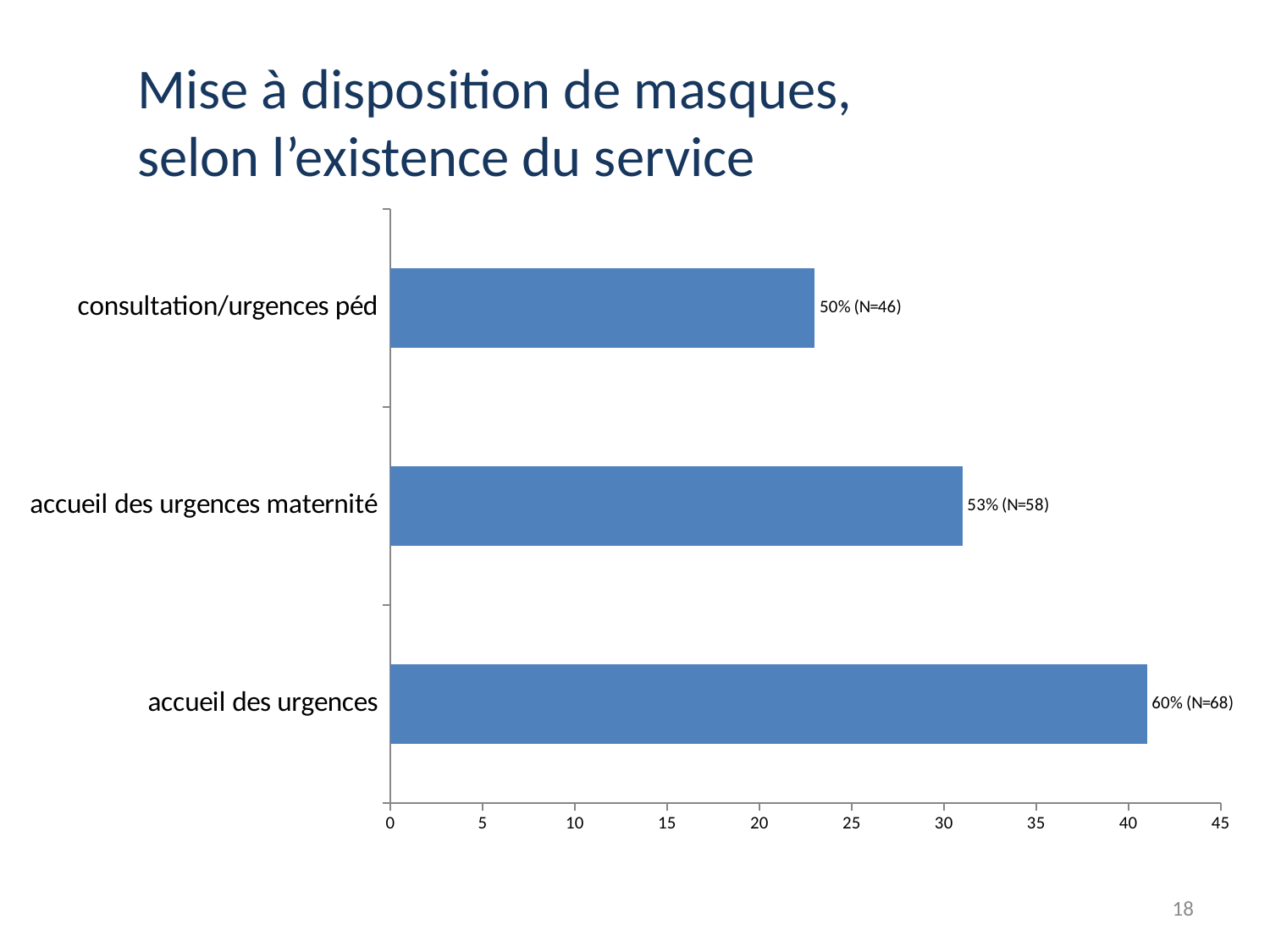
Which has a higher percentage, accueil des urgences maternité or consultation/urgences péd? accueil des urgences maternité Is the bar for accueil des urgences greater or less than 35 on the axis? greater What data label is shown on the bar for accueil des urgences maternité? 53% (N=58) Is the bar for consultation/urgences péd greater or less than 25 on the axis? less Which category has the shortest bar? consultation/urgences péd Which category has the longest bar? accueil des urgences What data label is shown on the bar for accueil des urgences? 60% (N=68) What kind of chart is shown on the slide? bar chart What is the title of the slide? Mise à disposition de masques, selon l'existence du service What is the difference in percentage points between accueil des urgences (60%) and consultation/urgences péd (50%)? 10 percentage points How many categories are shown in the chart? 3 What data label is shown on the bar for consultation/urgences péd? 50% (N=46)